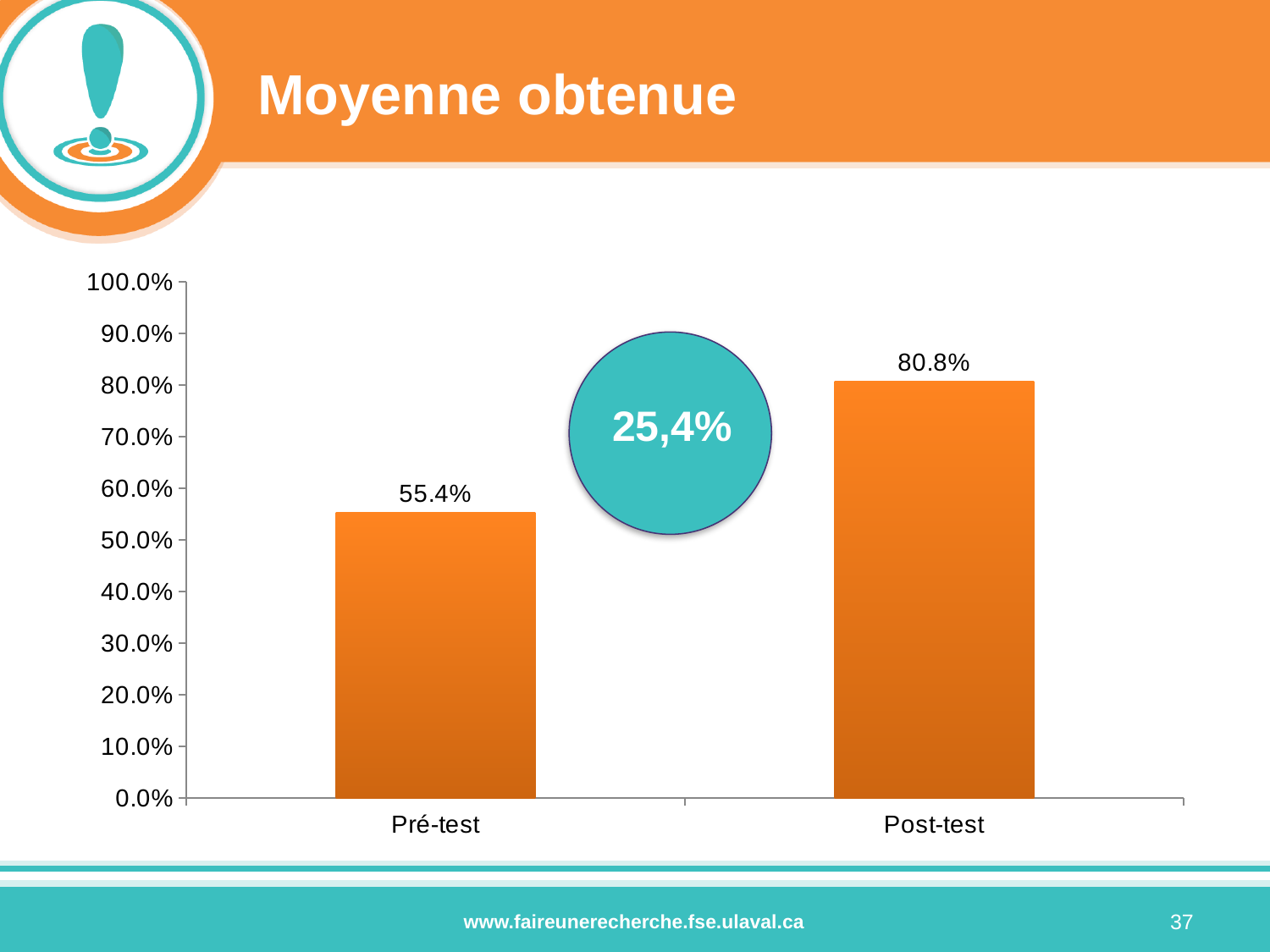
What is the difference between the Post-test and Pré-test values? 25.4% How many categories are shown on the x axis? 2 Which category has the lowest value? Pré-test What kind of chart is shown on the slide? bar chart What is the value for Pré-test? 55.4% What value is printed in the circle between the two bars? 25,4% Is the value for Post-test greater or less than 80.0%? greater Do the values rise or fall from Pré-test to Post-test? rise What is the value for Post-test? 80.8% Which is larger, the value for Pré-test or the value for Post-test? Post-test Is the value for Pré-test greater or less than 60.0%? less Which category has the highest value? Post-test